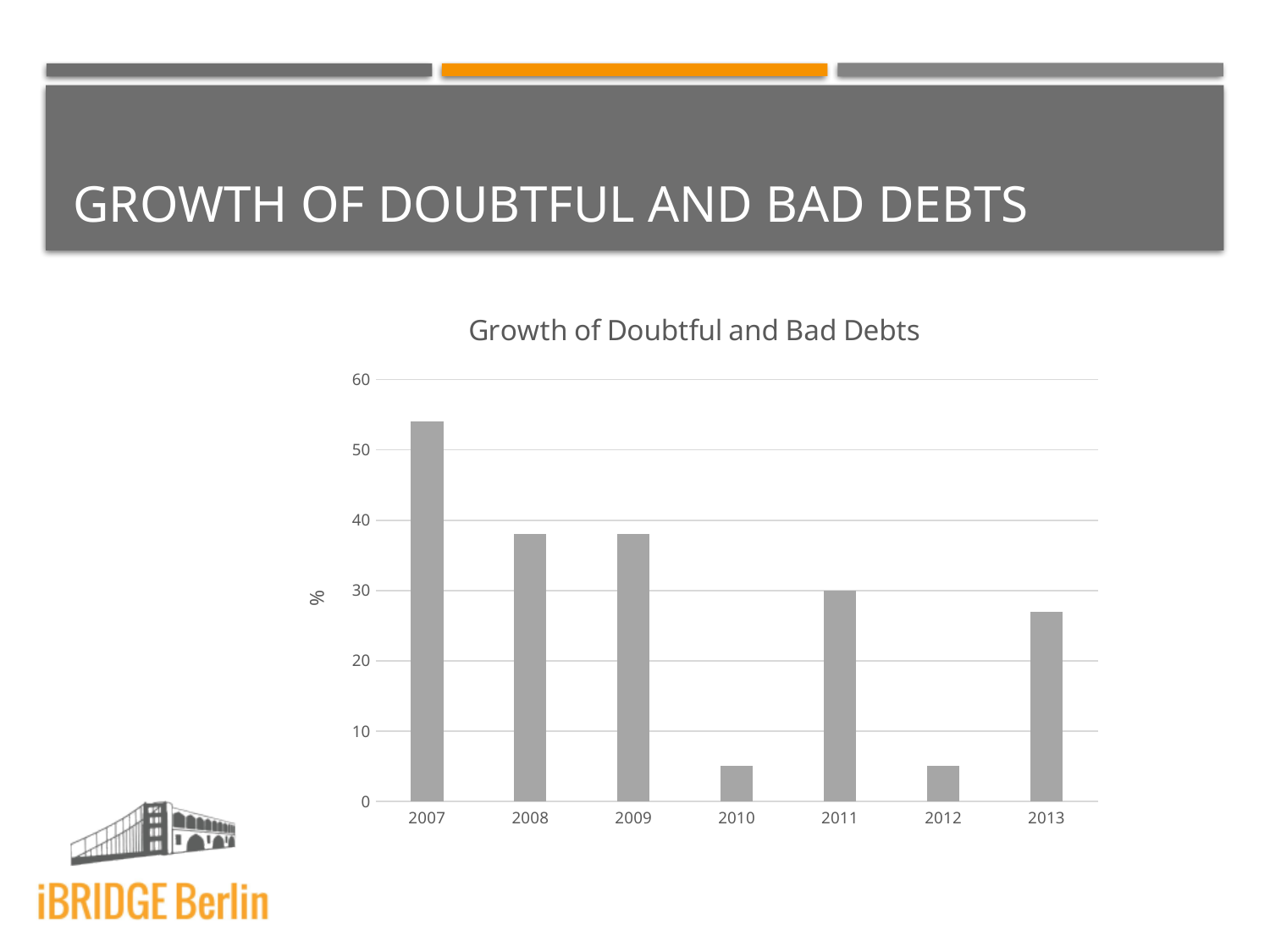
Is the value for 2007 greater or less than 50? greater Which year has the highest value in the chart? 2007 Which is larger, the value for 2012 or the value for 2011? 2011 Is the value for 2008 greater or less than 40? less How many years are shown on the x axis of the chart? 7 What is the title of the chart? Growth of Doubtful and Bad Debts What type of chart is shown on the slide? Bar chart Is the value for 2013 greater or less than 30? less What is the value for 2011? 30 What is the label on the vertical axis of the chart? % Which is larger, the value for 2007 or the value for 2013? 2007